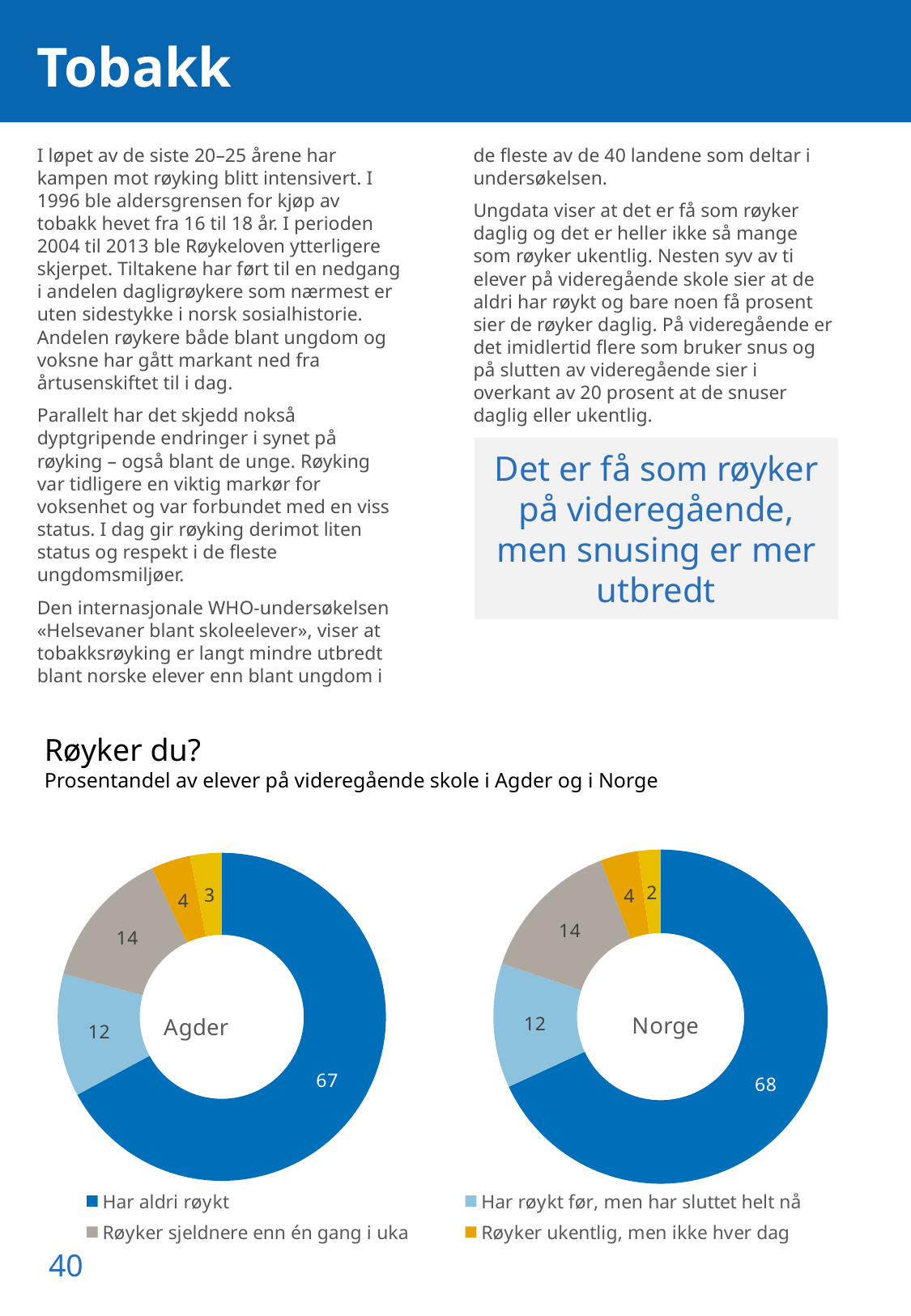
In the Norge chart, what is the value for "Røyker sjeldnere enn én gang i uka"? 14 In the Agder chart, which category has the largest slice? Har aldri røykt In the Agder chart, what percentage of students answered "Har aldri røykt"? 67 In the Agder chart, what is the difference between "Har aldri røykt" and "Røyker sjeldnere enn én gang i uka"? 53 In the Norge chart, what is the value for "Røyker ukentlig, men ikke hver dag"? 4 In the Norge chart, what is the value of the smallest slice? 2 In the Agder chart, what is the value for "Har røykt før, men har sluttet helt nå"? 12 What kind of chart is used to show the "Røyker du?" data? Pie (donut) chart In the Norge chart, what percentage of students answered "Har aldri røykt"? 68 In the Agder chart, what is the value of the smallest slice? 3 Which chart has the larger value for "Har aldri røykt", Agder or Norge? Norge How many entries does the legend below the charts list? 4